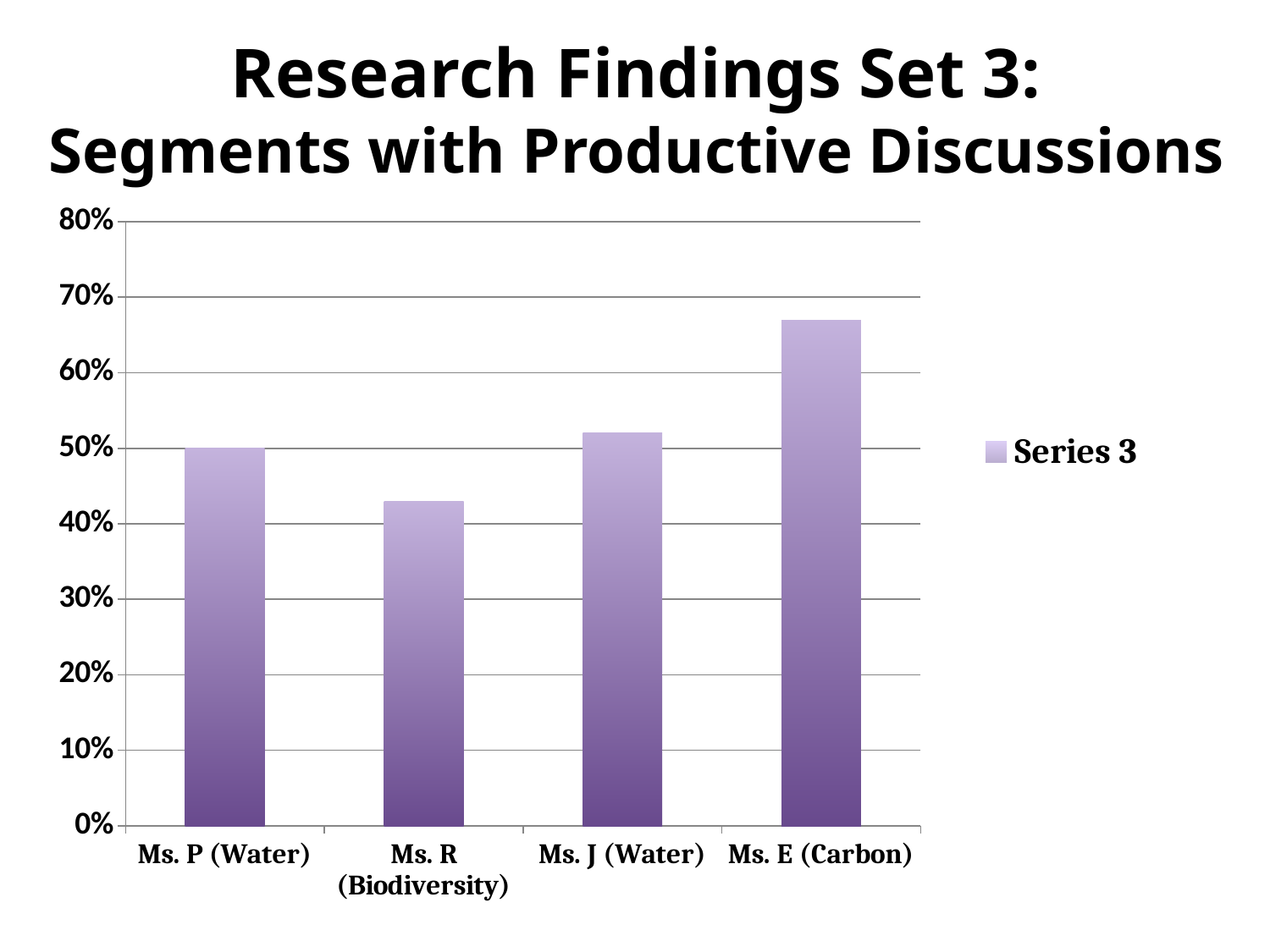
What is the name of the series listed in the legend? Series 3 Which is larger, the value for Ms. E (Carbon) or the value for Ms. P (Water)? Ms. E (Carbon) What kind of chart is shown on the slide? bar chart What is the title of the chart on the slide? Research Findings Set 3: Segments with Productive Discussions What is the value for Ms. P (Water)? 50% Which category has the lowest bar? Ms. R (Biodiversity) Is the value for Ms. R (Biodiversity) greater or less than 50%? less Which category has the highest bar? Ms. E (Carbon) How many categories are shown on the x axis of the chart? 4 Is the value for Ms. E (Carbon) greater or less than 60%? greater Is the value for Ms. J (Water) greater or less than 60%? less How many series does the chart's legend list? 1